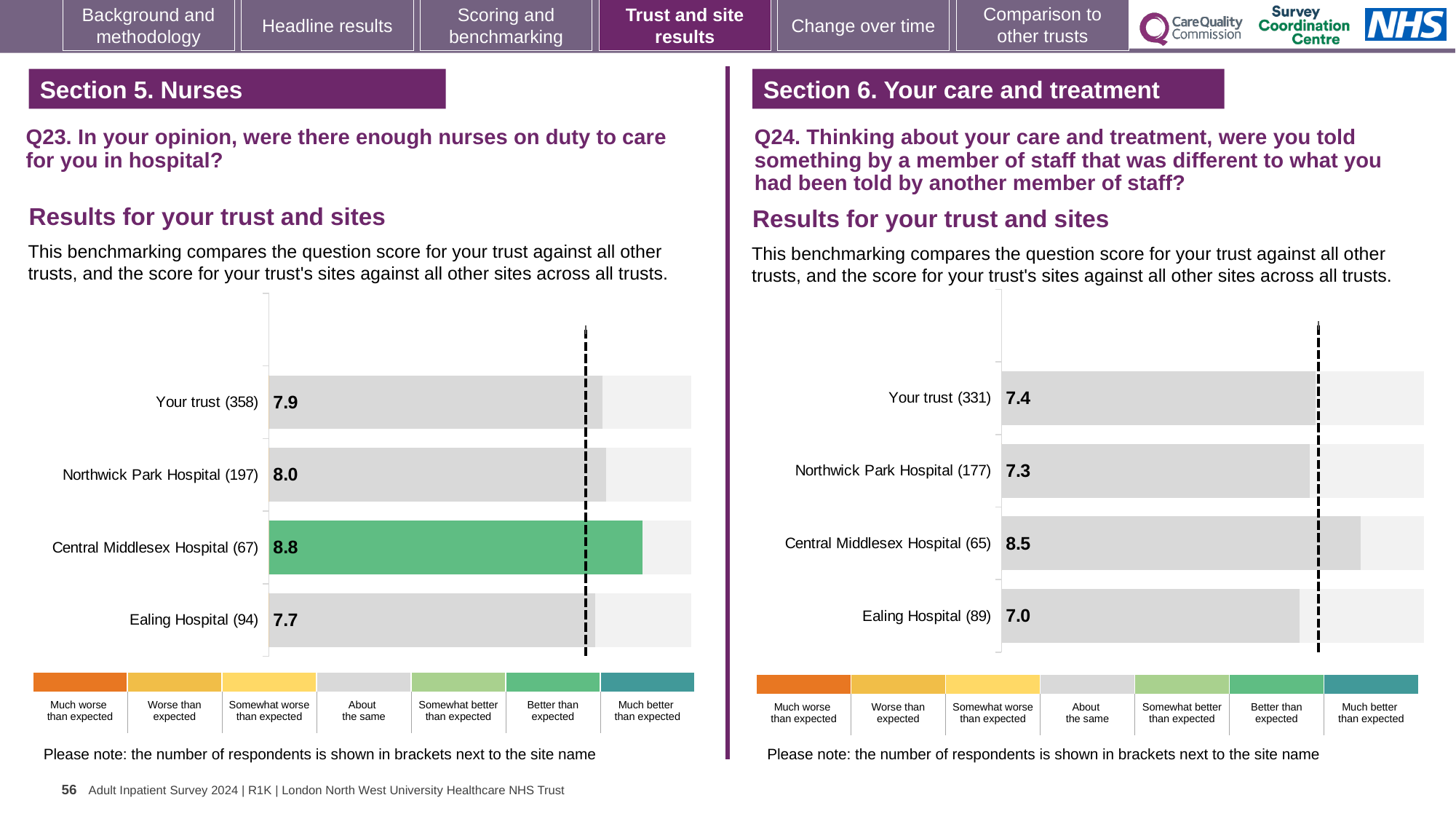
On the Q24 chart (right), what is the score for Ealing Hospital (89)? 7.0 On the Q23 chart (left), which bar is coloured green? Central Middlesex Hospital (67) On the Q23 chart (left), what is the score for Your trust (358)? 7.9 On the Q23 chart (left), what is the difference between the scores for Central Middlesex Hospital (67) and Ealing Hospital (94)? 1.1 On the Q23 chart (left), which site has the highest score? Central Middlesex Hospital (67) On the Q24 chart (right), what is the score for Northwick Park Hospital (177)? 7.3 On the Q23 chart (left), which site has the lowest score? Ealing Hospital (94) What kind of chart is used on the Q24 chart (right)? Bar chart On the Q24 chart (right), which site has the highest score? Central Middlesex Hospital (65) On the Q23 chart (left), how many bars are plotted? 4 On the Q24 chart (right), which is larger, the score for Your trust (331) or Ealing Hospital (89)? Your trust (331) On the Q24 chart (right), what is the difference between the scores for Central Middlesex Hospital (65) and Your trust (331)? 1.1